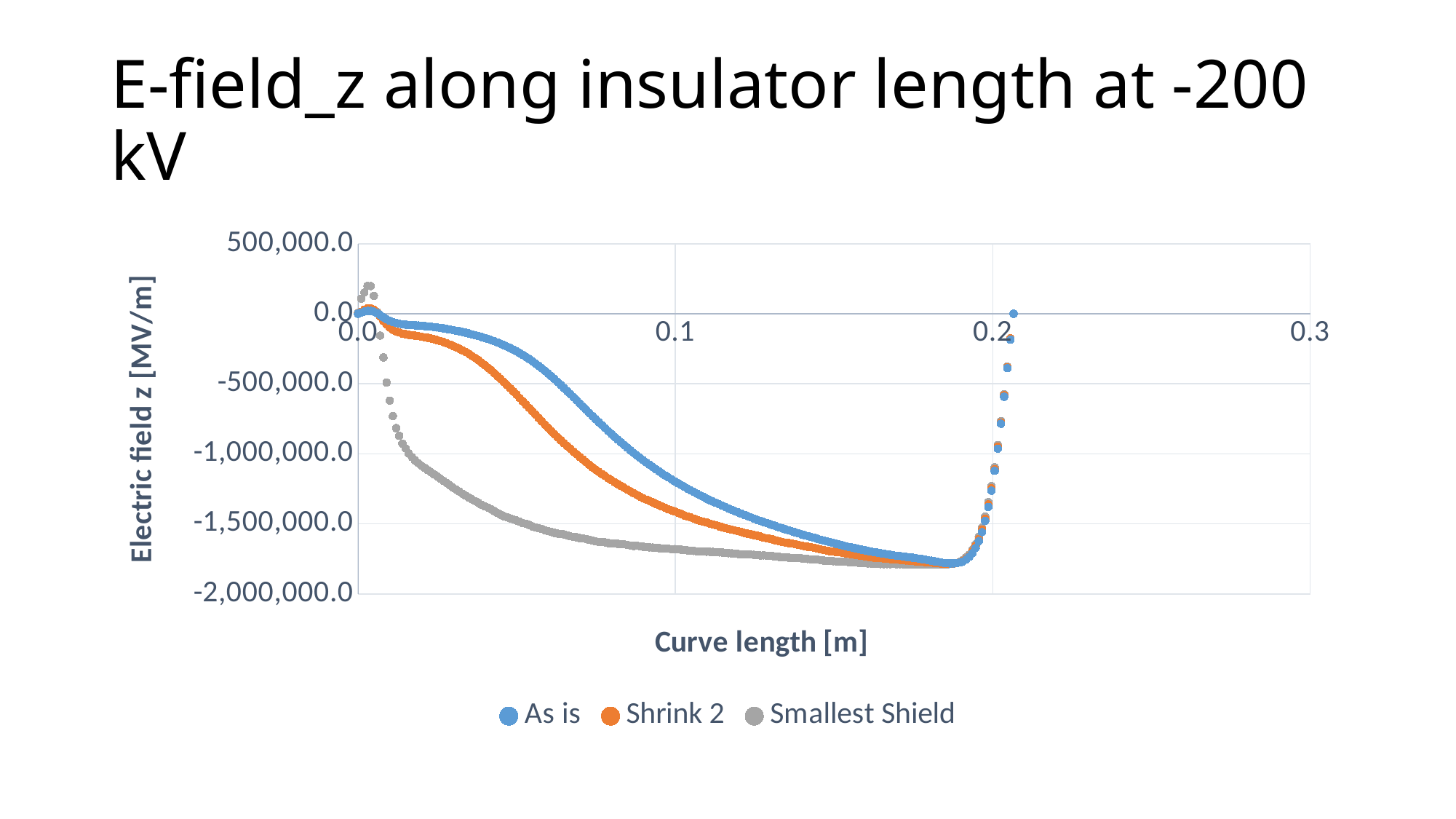
At a curve length of 0.05 m, is the value for Smallest Shield greater or less than -1,000,000.0? less At a curve length of 0.1 m, is the value for As is greater or less than -1,000,000.0? less What is the title of the x axis? Curve length [m] Between curve lengths of 0.0 m and 0.1 m, do the values for As is rise or fall? fall Which series are listed in the legend? As is, Shrink 2, Smallest Shield At a curve length of 0.05 m, which series has the larger value, As is or Smallest Shield? As is At a curve length of 0.1 m, is the value for As is greater or less than -1,500,000.0? greater What kind of chart is shown on the slide? scatter chart At a curve length of 0.1 m, which series has the highest (least negative) electric field value? As is At a curve length of 0.1 m, which series has the lowest (most negative) electric field value? Smallest Shield How many series does the legend list? 3